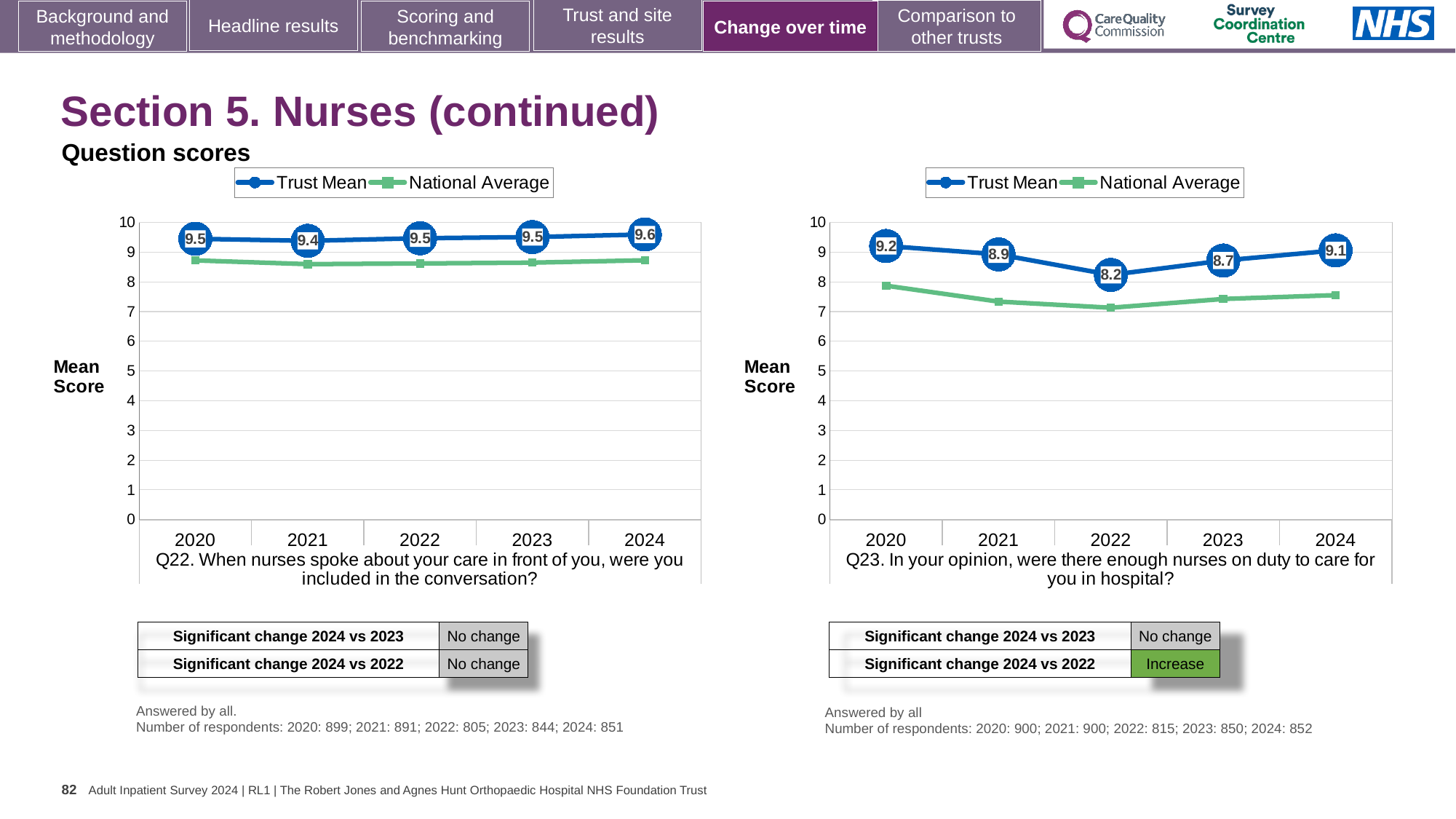
In the Q23 chart on the right, is the National Average value for 2022 greater or less than 8? less What type of chart is the Q22 chart on the left? Line chart In the Q23 chart on the right, what is the difference between the Trust Mean scores for 2024 and 2022? 0.9 How many series does the legend of the Q23 chart on the right list? 2 In the Q23 chart on the right, what is the Trust Mean score for 2022? 8.2 In the Q23 chart on the right, is the Trust Mean score for 2020 higher or lower than for 2021? higher In the Q22 chart on the left, is the National Average value for 2020 greater or less than 8? greater In the Q22 chart on the left, what is the Trust Mean score for 2024? 9.6 How many years are plotted on the x axis of the Q22 chart on the left? 5 In the Q23 chart on the right, which year has the lowest Trust Mean score? 2022 In the Q22 chart on the left, which year has the lowest Trust Mean score? 2021 In the Q23 chart on the right, which year has the highest Trust Mean score? 2020